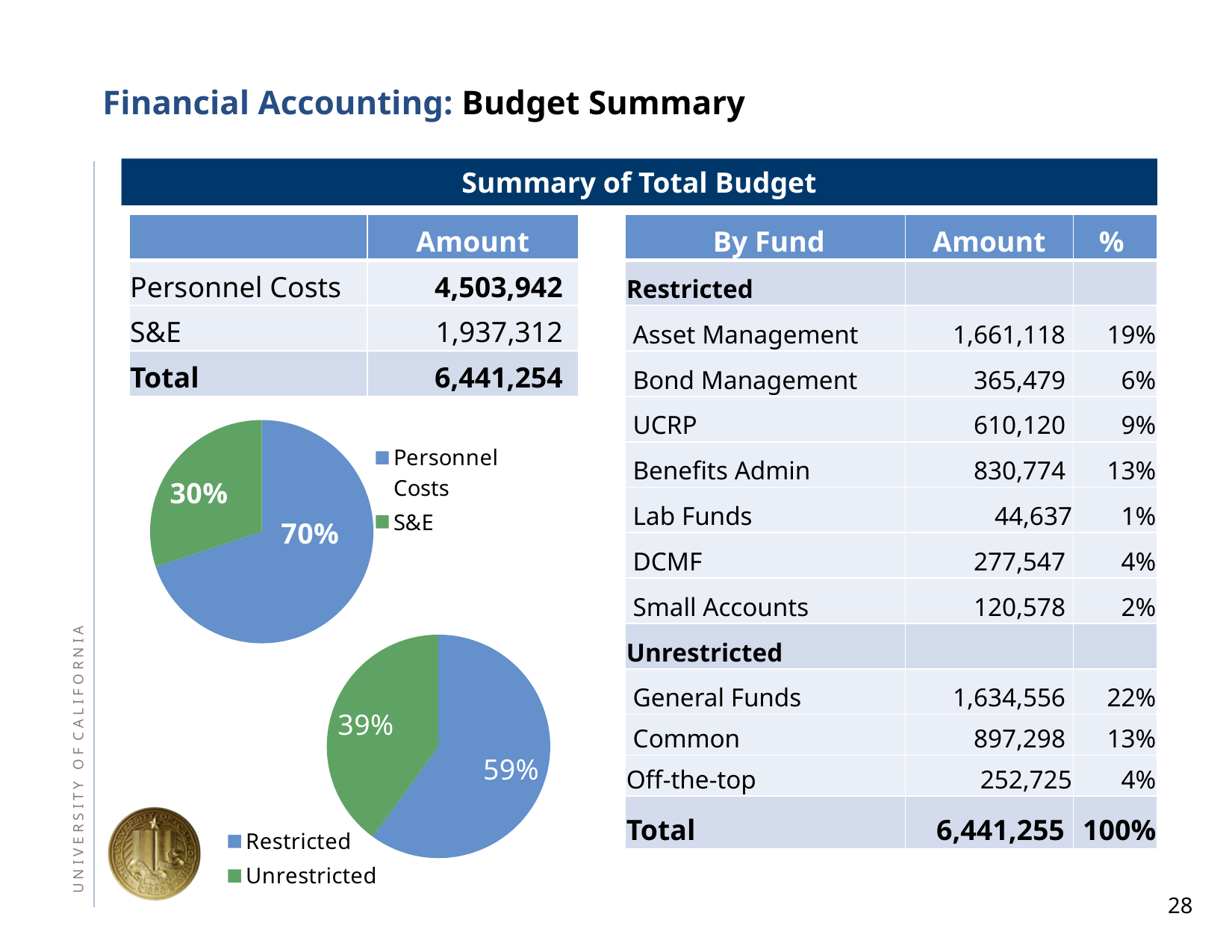
In the upper pie chart, what share is labelled for S&E? 30% In the lower pie chart, what colour is the Unrestricted slice? Green How many slices does the upper pie chart have? 2 In the upper pie chart, what share is labelled for Personnel Costs? 70% In the lower pie chart, which slice is larger, Restricted or Unrestricted? Restricted What type of chart is the lower chart on the slide? Pie chart In the lower pie chart, what is the difference in percentage points between the Restricted slice and the Unrestricted slice? 20 In the upper pie chart, which slice is the largest? Personnel Costs In the lower pie chart, what share is labelled for Unrestricted? 39% In the lower pie chart, which slice is the smallest? Unrestricted In the upper pie chart, what is the difference in percentage points between the Personnel Costs slice and the S&E slice? 40